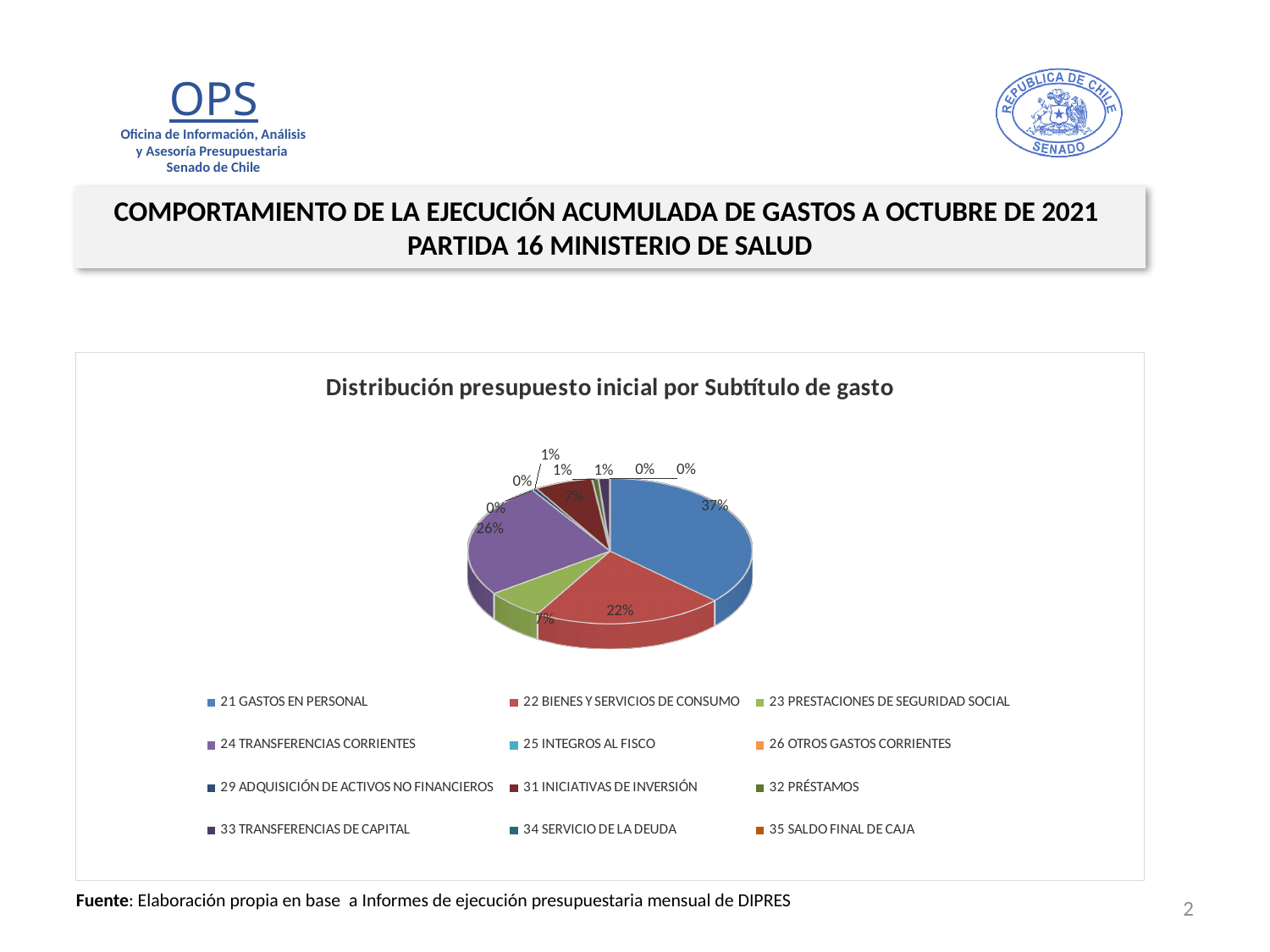
What is the difference in percentage points between the share for 24 TRANSFERENCIAS CORRIENTES and the share for 22 BIENES Y SERVICIOS DE CONSUMO? 4 percentage points What is the difference in percentage points between the share for 21 GASTOS EN PERSONAL and the share for 22 BIENES Y SERVICIOS DE CONSUMO? 15 percentage points What is the title of the chart? Distribución presupuesto inicial por Subtítulo de gasto Which is larger, the share for 21 GASTOS EN PERSONAL or the share for 24 TRANSFERENCIAS CORRIENTES? 21 GASTOS EN PERSONAL What share of the pie does 21 GASTOS EN PERSONAL represent? 37% What share of the pie does 23 PRESTACIONES DE SEGURIDAD SOCIAL represent? 7% What share of the pie does 24 TRANSFERENCIAS CORRIENTES represent? 26% Which is larger, the share for 22 BIENES Y SERVICIOS DE CONSUMO or the share for 24 TRANSFERENCIAS CORRIENTES? 24 TRANSFERENCIAS CORRIENTES How many categories does the chart legend list? 12 What kind of chart is shown on the slide? Pie chart Which category has the largest share of the pie? 21 GASTOS EN PERSONAL